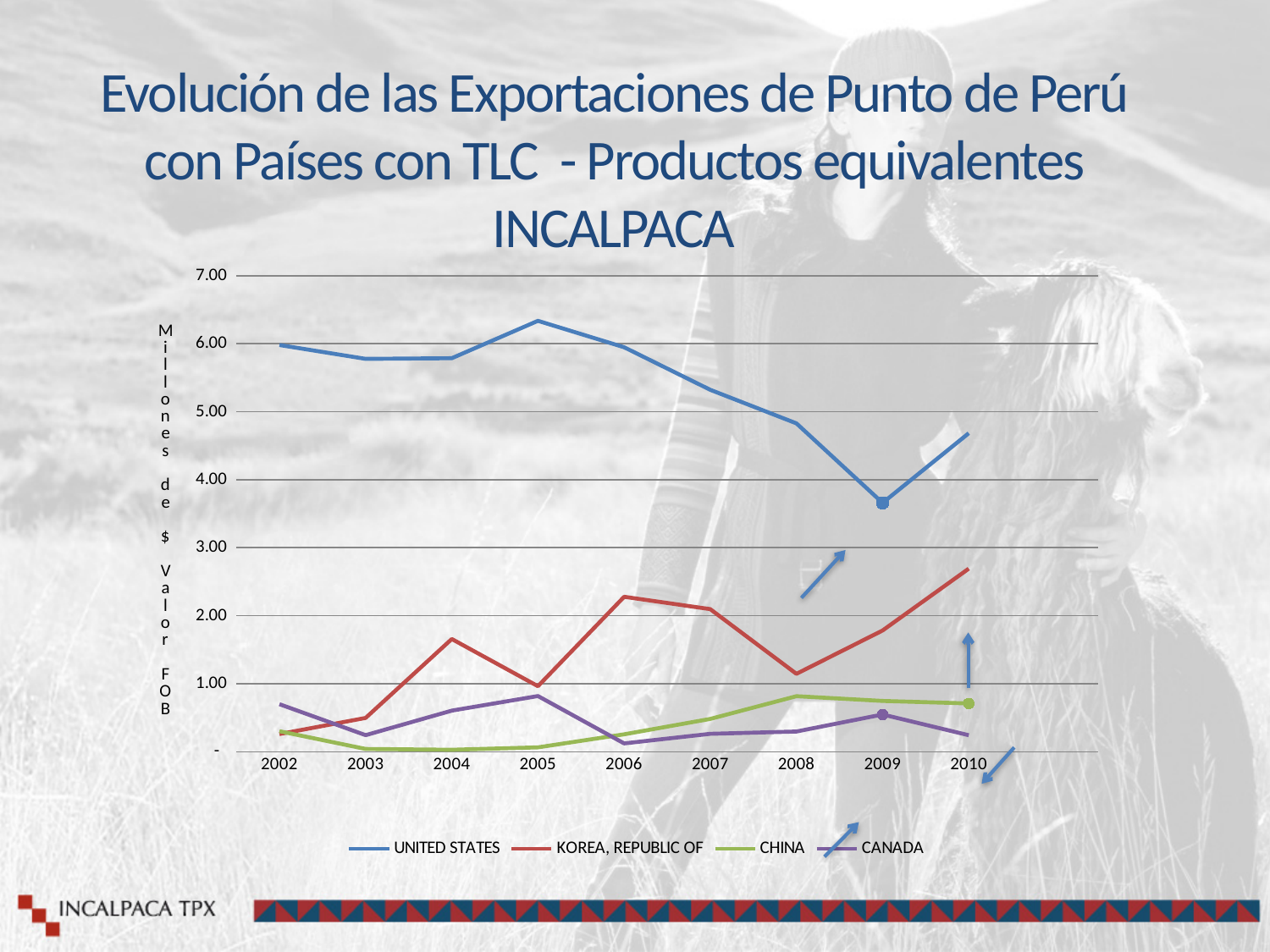
Is the value for KOREA, REPUBLIC OF in 2010 greater or less than 2.00? greater Is the value for UNITED STATES in 2009 greater or less than 4.00? less Which series is drawn in green? CHINA How many series does the legend list? 4 Which series has the lowest value in 2004? CHINA What kind of chart is shown on the slide? line chart How many years are shown on the x axis? 9 Does the UNITED STATES line rise or fall from 2005 to 2009? fall Which series has the highest value in 2002? UNITED STATES Is the value for UNITED STATES in 2005 greater or less than 6.00? greater In 2010, which is larger: the value for KOREA, REPUBLIC OF or the value for CHINA? KOREA, REPUBLIC OF